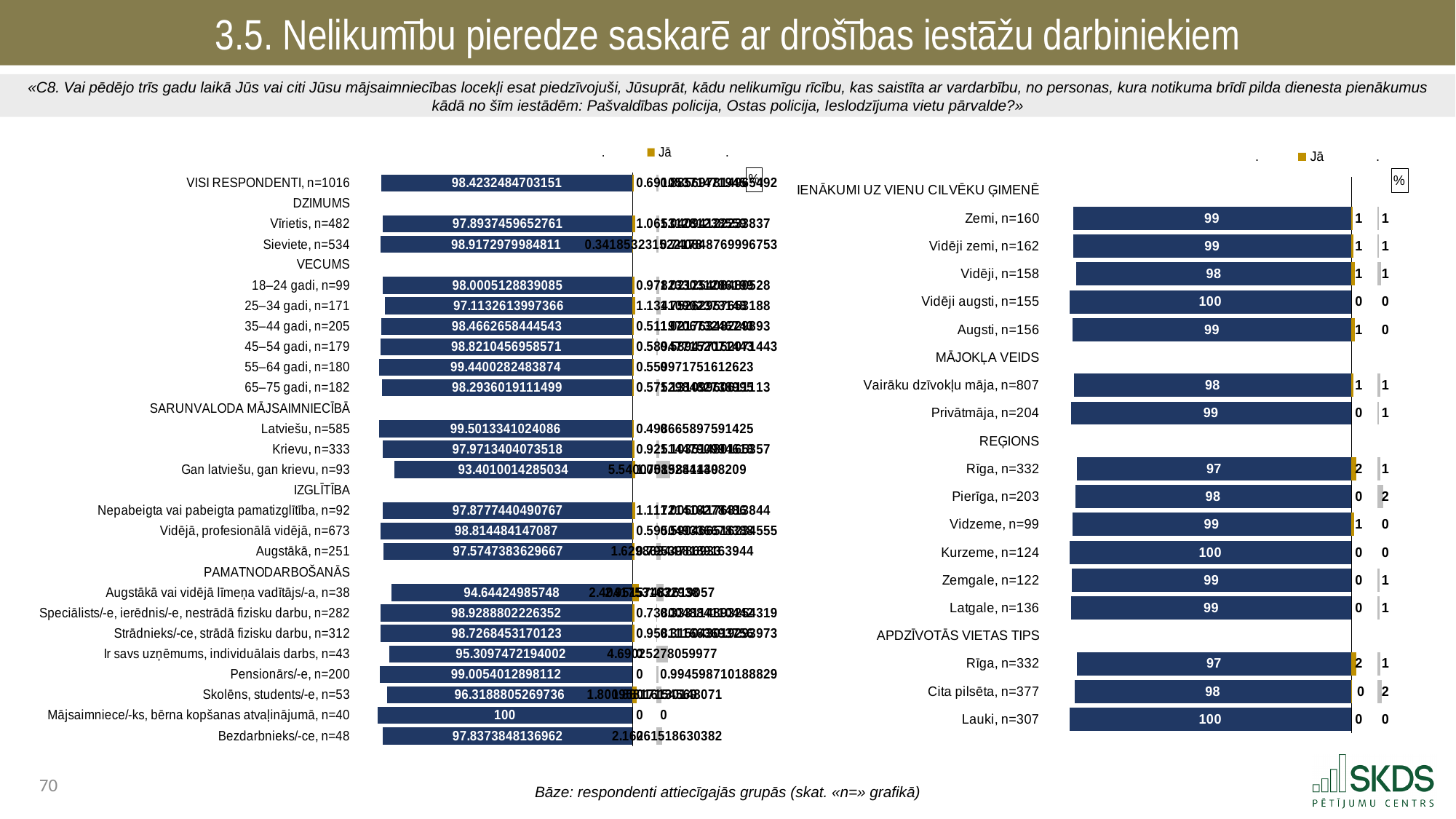
In the right chart, what is the value of the dark blue bar for Rīga, n=332 under REĢIONS? 97 How many category bars are plotted in the right chart? 16 In the right chart, what is the value of the dark blue bar for Kurzeme, n=124? 100 In the right chart, which region under REĢIONS has the lowest dark blue bar value? Rīga, n=332 In the right chart, which has the larger dark blue bar value: Lauki, n=307 or Cita pilsēta, n=377? Lauki, n=307 In the left chart, what is the value of the dark blue bar for Mājsaimniece/-ks, bērna kopšanas atvaļinājumā, n=40? 100 In the left chart, what is the value of the dark blue bar for Gan latviešu, gan krievu, n=93? 93.4010014285034 In the right chart, what is the difference between the dark blue bar values for Kurzeme, n=124 and Rīga, n=332? 3 In the right chart, which income group under IENĀKUMI UZ VIENU CILVĒKU ĢIMENĒ has the highest dark blue bar value? Vidēji augsti, n=155 In the right chart, what is the value of the dark blue bar for Vairāku dzīvokļu māja, n=807? 98 What type of chart is used on the left side of the slide? bar chart In the left chart, which category has the lowest dark blue bar value? Gan latviešu, gan krievu, n=93